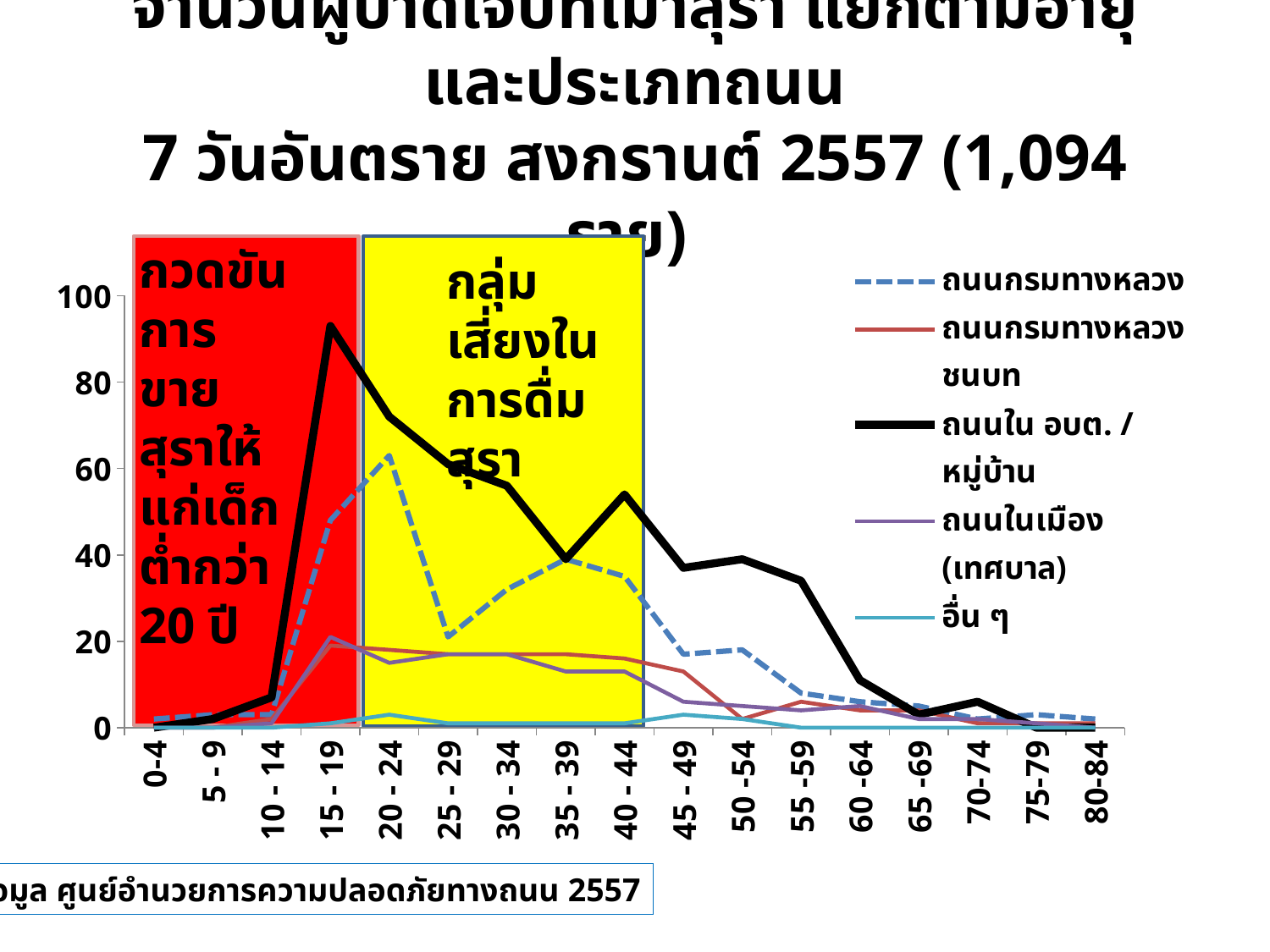
Is the value for ถนนกรมทางหลวง at age group 20 - 24 greater or less than 60? greater At age group 50 -54, which series has the larger value: ถนนใน อบต. / หมู่บ้าน or ถนนกรมทางหลวง? ถนนใน อบต. / หมู่บ้าน How many series does the legend list? 5 Which series reaches the highest peak on the chart? ถนนใน อบต. / หมู่บ้าน Does the value for ถนนใน อบต. / หมู่บ้าน rise or fall from age group 15 - 19 to 35 - 39? fall What kind of chart is shown on the slide? line chart For the series ถนนใน อบต. / หมู่บ้าน, which age group has the highest value? 15 - 19 Is the value for ถนนใน อบต. / หมู่บ้าน at age group 40 - 44 greater or less than 40? greater Is the value for ถนนใน อบต. / หมู่บ้าน at age group 60 -64 greater or less than 20? less How many age-group categories are shown on the x axis? 17 Which series is drawn as a dashed line? ถนนกรมทางหลวง